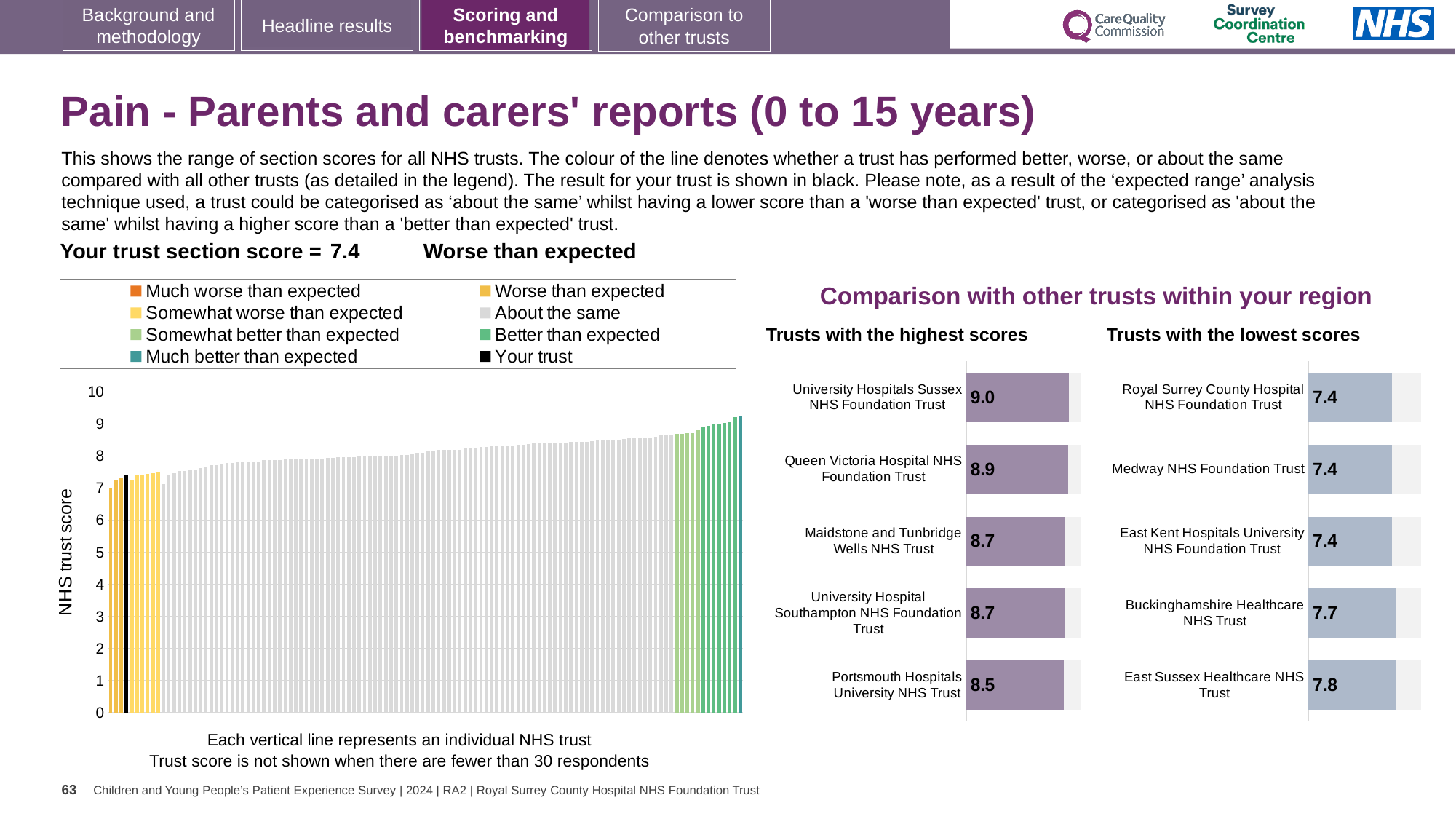
In the 'Trusts with the highest scores' chart, which trust has the lowest score? Portsmouth Hospitals University NHS Trust In the 'Trusts with the lowest scores' chart, which trust has the highest score? East Sussex Healthcare NHS Trust In the 'Trusts with the highest scores' chart, what is the difference between the scores of University Hospitals Sussex NHS Foundation Trust and Portsmouth Hospitals University NHS Trust? 0.5 In the large chart on the left, what colour represents 'Your trust'? black In the 'Trusts with the lowest scores' chart, what is the score for Buckinghamshire Healthcare NHS Trust? 7.7 How many entries does the legend above the large chart on the left list? 8 In the 'Trusts with the highest scores' chart, what is the score for University Hospitals Sussex NHS Foundation Trust? 9.0 In the large chart on the left, what is the section score for your trust (the black bar)? 7.4 In the 'Trusts with the lowest scores' chart, which has the larger score: Buckinghamshire Healthcare NHS Trust or East Sussex Healthcare NHS Trust? East Sussex Healthcare NHS Trust In the large chart on the left, do the trust scores rise or fall from left to right? rise How many trusts are shown in the 'Trusts with the highest scores' chart? 5 What kind of chart is the large chart on the left showing NHS trust scores? bar chart